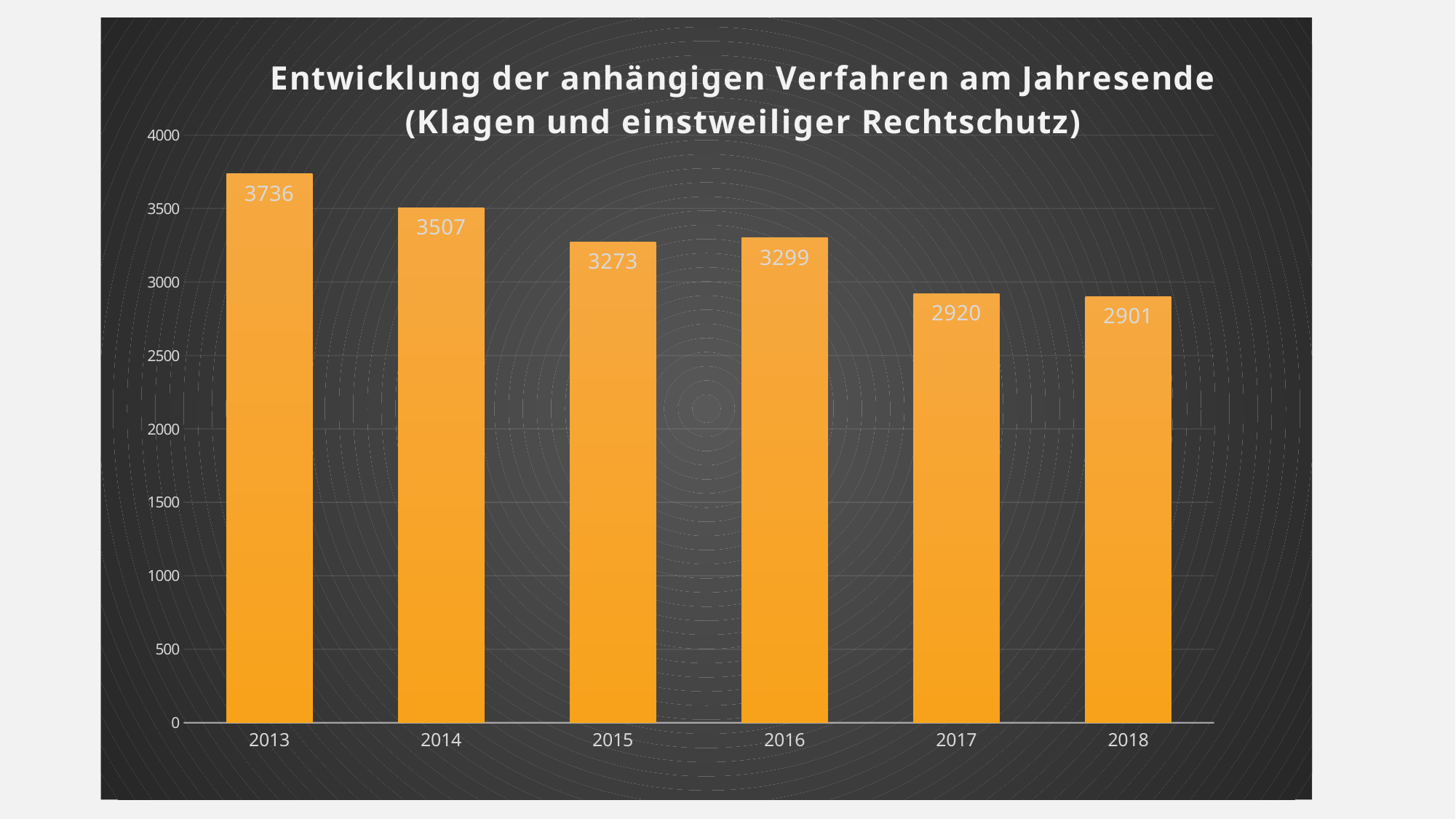
What is the difference between the values for 2013 and 2014? 229 What is the value for 2018? 2901 Is the value for 2017 greater or less than 3000? less What is the value for 2016? 3299 What kind of chart is shown? bar chart What is the title of the chart? Entwicklung der anhängigen Verfahren am Jahresende (Klagen und einstweiliger Rechtschutz) What is the difference between the values for 2017 and 2018? 19 Which year has the highest value? 2013 Which year has the lowest value? 2018 What is the value for 2013? 3736 Which is larger, the value for 2015 or the value for 2016? 2016 How many years are shown on the x axis? 6